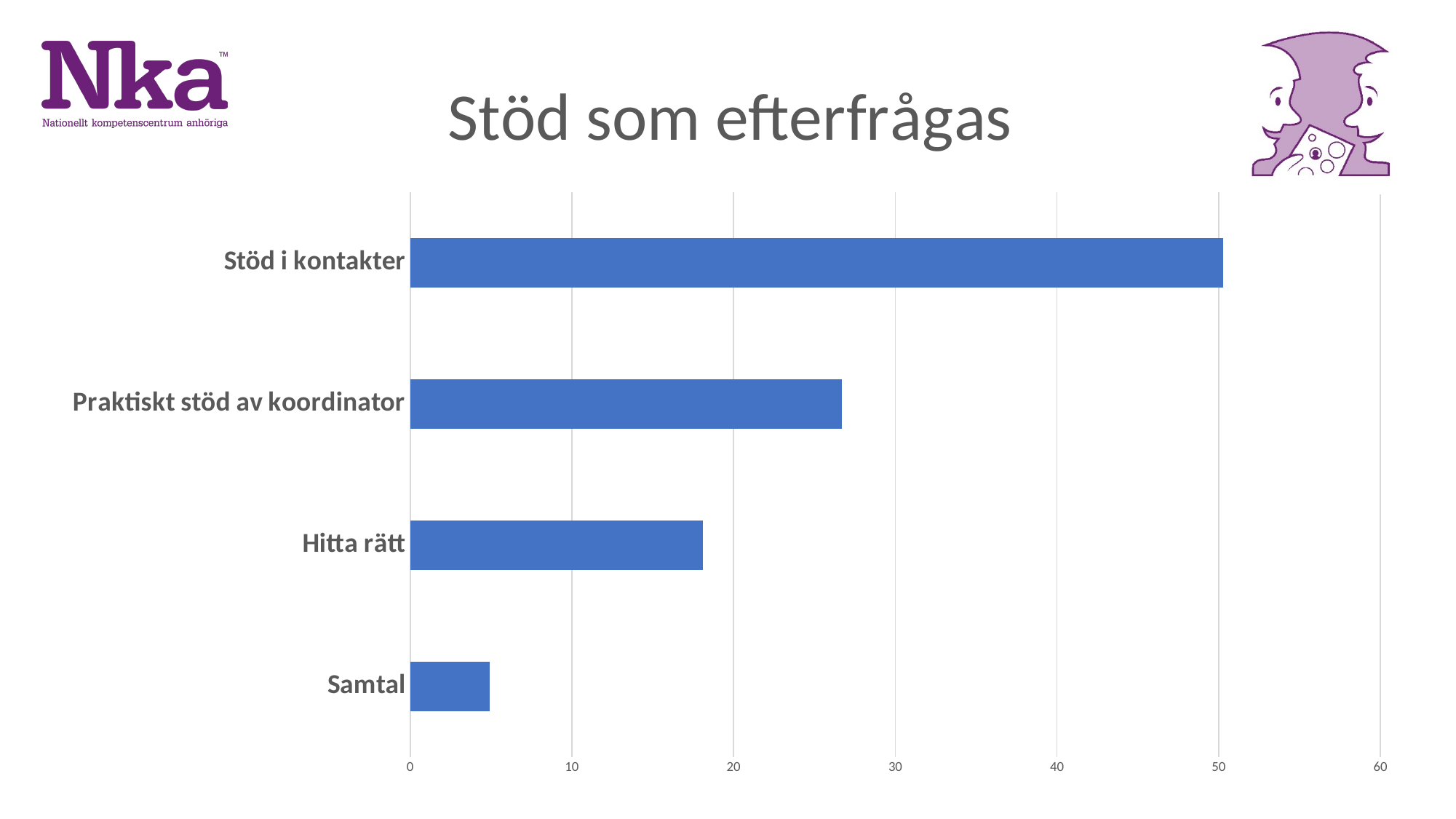
Is the value for Stöd i kontakter greater or less than 40? greater Which category has the highest value? Stöd i kontakter What is the title of the chart on the slide? Stöd som efterfrågas Which is larger, the value for Praktiskt stöd av koordinator or the value for Hitta rätt? Praktiskt stöd av koordinator Is the value for Hitta rätt greater or less than 20? less Is the value for Praktiskt stöd av koordinator greater or less than 20? greater Which category has the lowest value? Samtal Which is larger, the value for Hitta rätt or the value for Samtal? Hitta rätt How many categories are shown in the chart? 4 What kind of chart is shown on the slide? bar chart